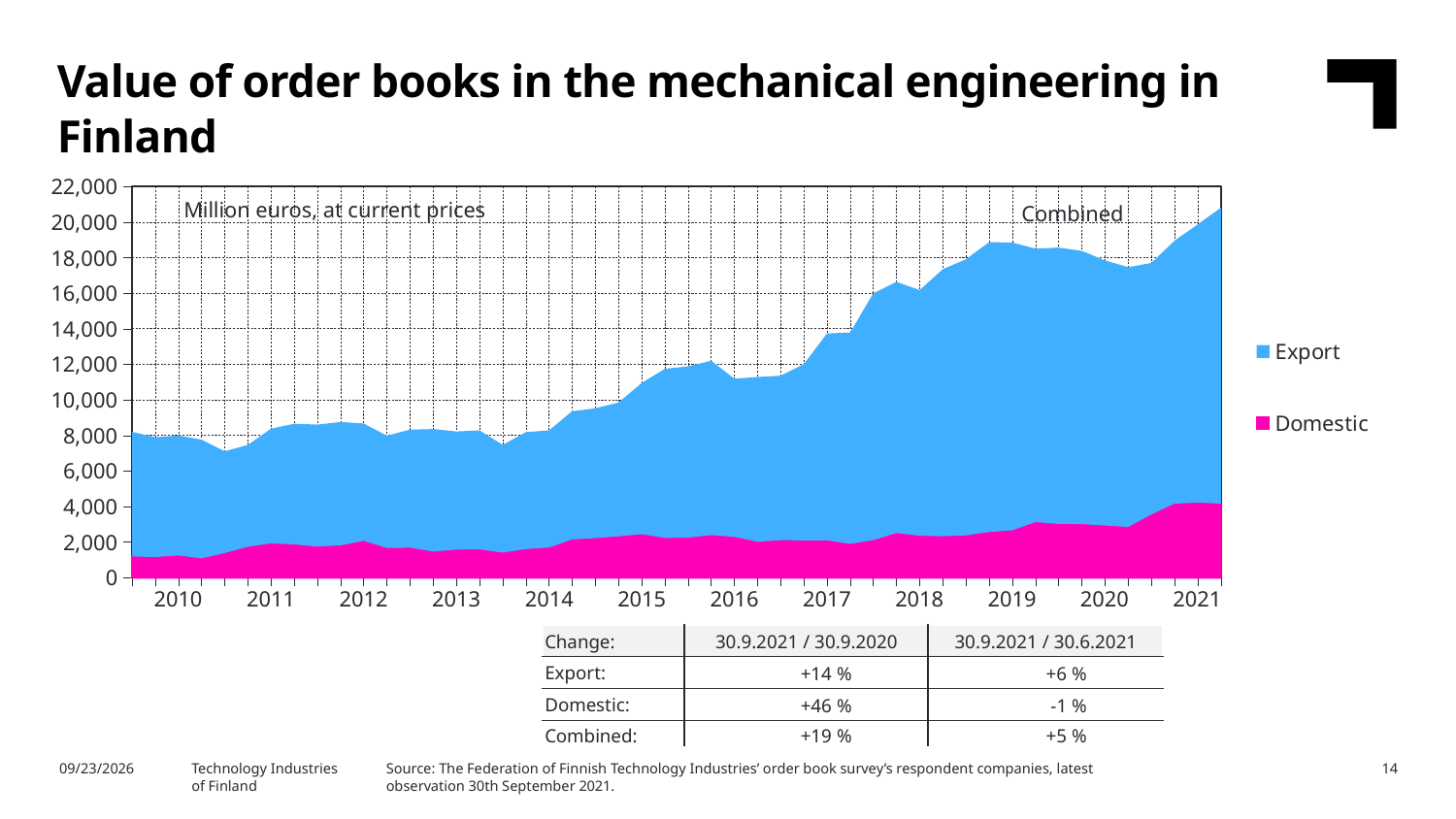
Is the Domestic value at the end of 2021 greater or less than 2,000? greater Does the combined value of order books rise or fall overall from 2010 to 2021? rise Is the combined value of order books at the end of 2021 greater or less than 20,000? greater Is the combined value of order books in 2019 greater or less than 16,000? greater What are the two series named in the chart legend? Export and Domestic How many series does the chart legend list? 2 How many years are labelled on the x axis of the chart? 12 What unit is stated for the values in the chart? Million euros, at current prices What kind of chart is shown on the slide? area chart Which series is larger in 2021, Export or Domestic? Export